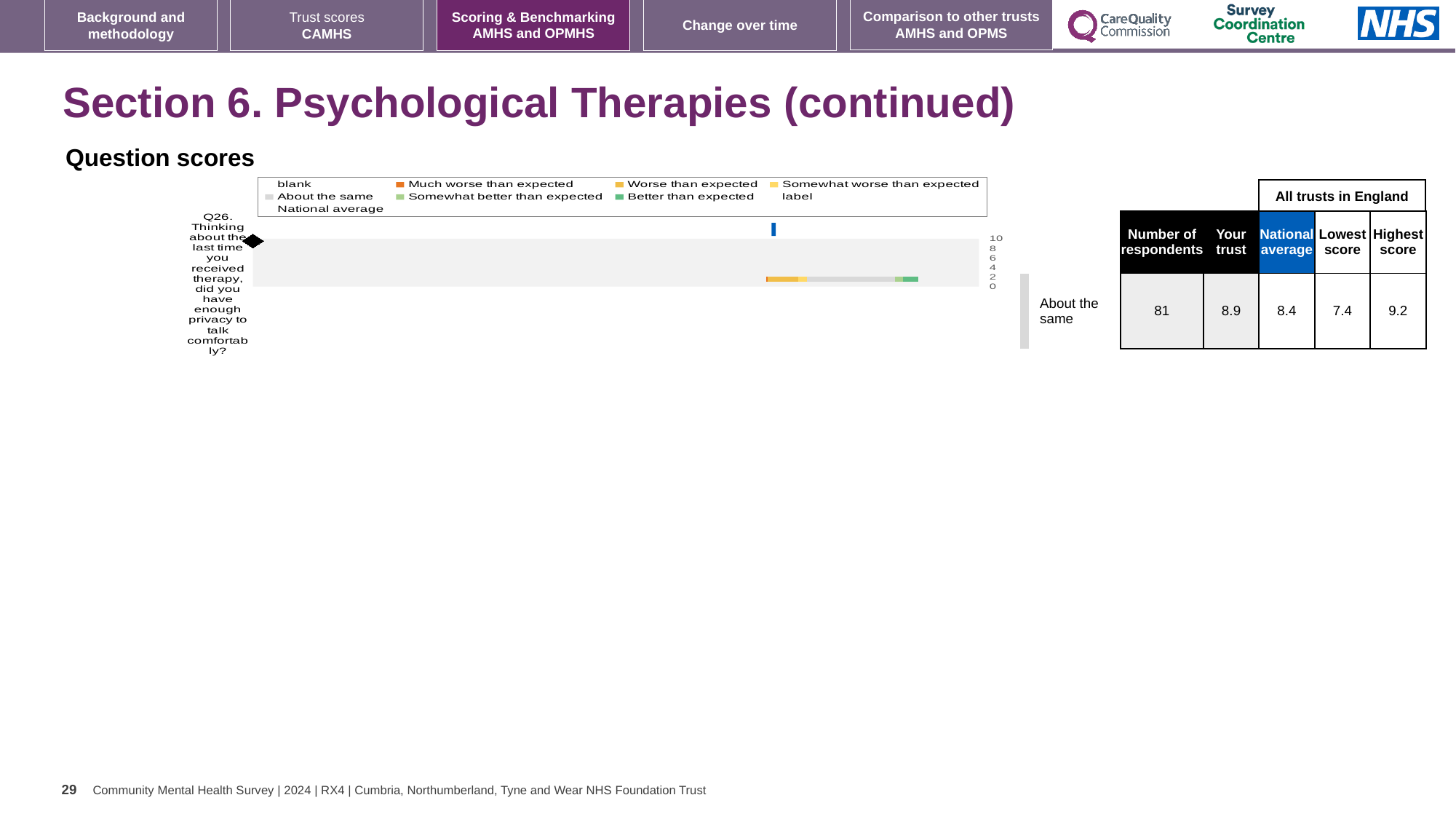
How many questions are plotted in the Question scores chart? 1 How is the trust's Q26 score categorised relative to expectations? About the same Which question is plotted in the Question scores chart? Q26. Thinking about the last time you received therapy, did you have enough privacy to talk comfortably? What is the national average score for Q26? 8.4 What is the lowest score among all trusts in England for Q26? 7.4 What is the highest score among all trusts in England for Q26? 9.2 Is the trust's score for Q26 greater or less than 6 on the chart axis? greater Which is larger for Q26, the trust's score or the national average? the trust's score What is the difference between the trust's score and the national average for Q26? 0.5 What kind of chart is shown under 'Question scores'? bar chart How many respondents answered Q26? 81 What is the 'Your trust' score for Q26? 8.9